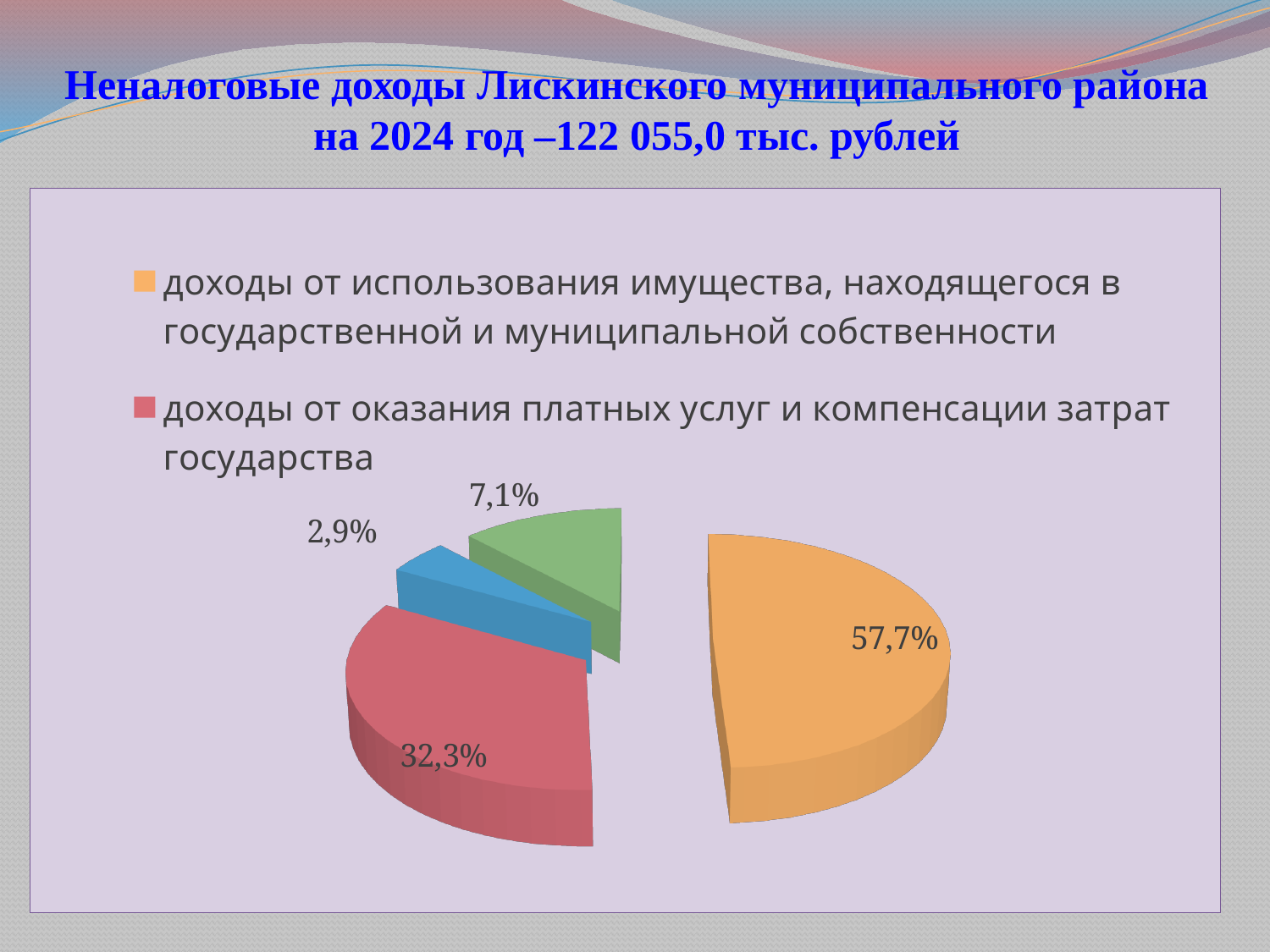
What share of the pie is labelled for "доходы от оказания платных услуг и компенсации затрат государства"? 32,3% Which legend category has the largest slice of the pie? доходы от использования имущества, находящегося в государственной и муниципальной собственности What total amount of non-tax revenue for 2024 is stated in the slide title? 122 055,0 тыс. рублей What is the largest percentage label shown on the pie chart? 57,7% Which slice is larger: the one for "доходы от оказания платных услуг и компенсации затрат государства" or the one labelled 7,1%? доходы от оказания платных услуг и компенсации затрат государства What kind of chart is shown on the slide? Pie chart By how many percentage points does the slice for "доходы от использования имущества" exceed the slice for "доходы от оказания платных услуг и компенсации затрат государства"? 25,4% What share of the pie is labelled for "доходы от использования имущества, находящегося в государственной и муниципальной собственности"? 57,7% How many entries does the legend list? 2 What is the smallest percentage label shown on the pie chart? 2,9% What colour is the slice labelled 32,3%? Red How many slices does the pie chart have? 4